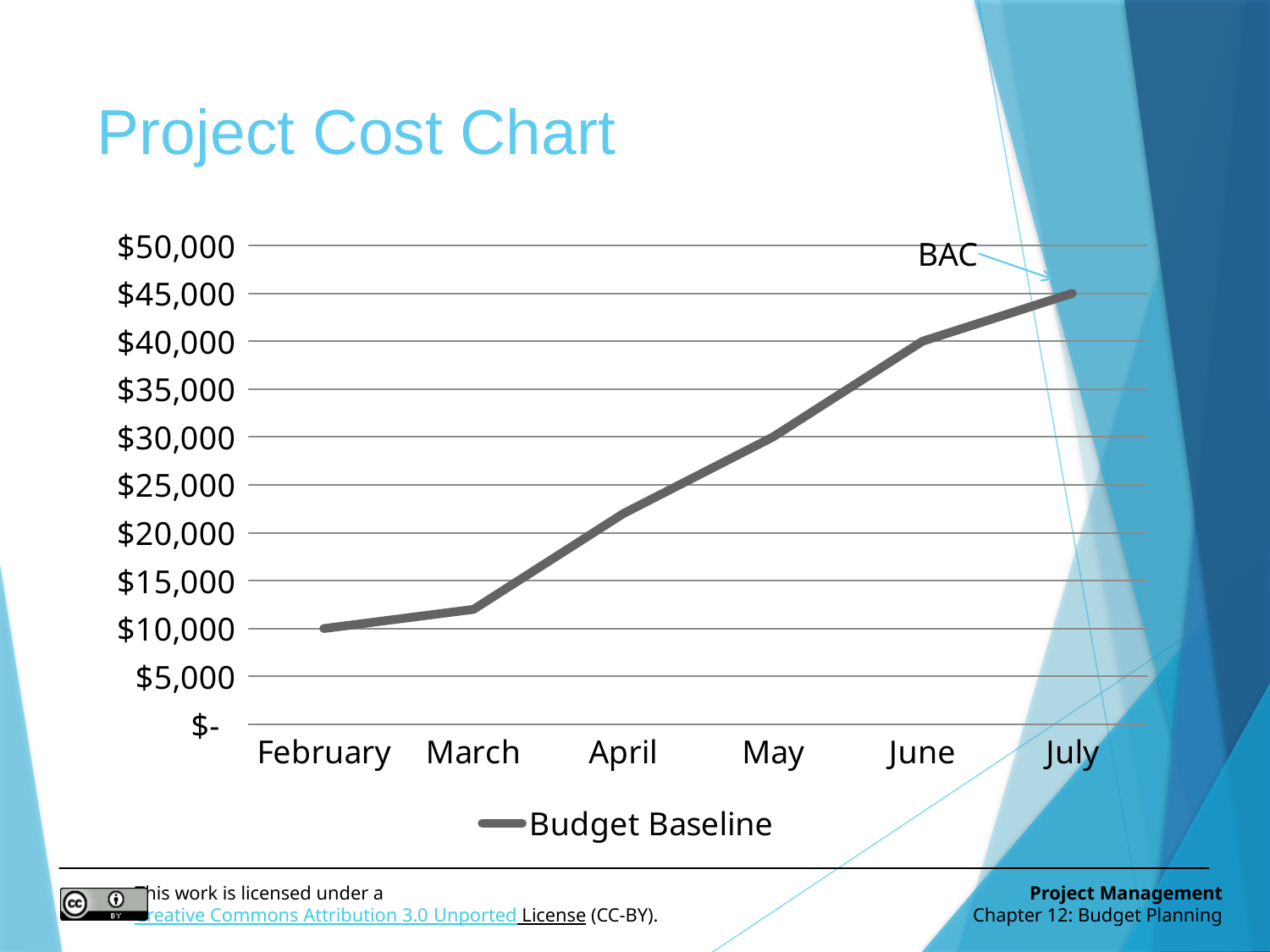
What is the name of the series shown in the legend? Budget Baseline How many series does the legend list? 1 What is the title of the chart? Project Cost Chart What is the Budget Baseline value for July? $45,000 What is the Budget Baseline value for February? $10,000 Is the Budget Baseline value for March greater or less than $15,000? less What kind of chart is shown on the slide? line chart How many months are plotted along the x axis? 6 Is the Budget Baseline value for April greater or less than $20,000? greater Which month has the lowest Budget Baseline value? February Which month has the highest Budget Baseline value? July Does the Budget Baseline rise or fall from February to July? rise